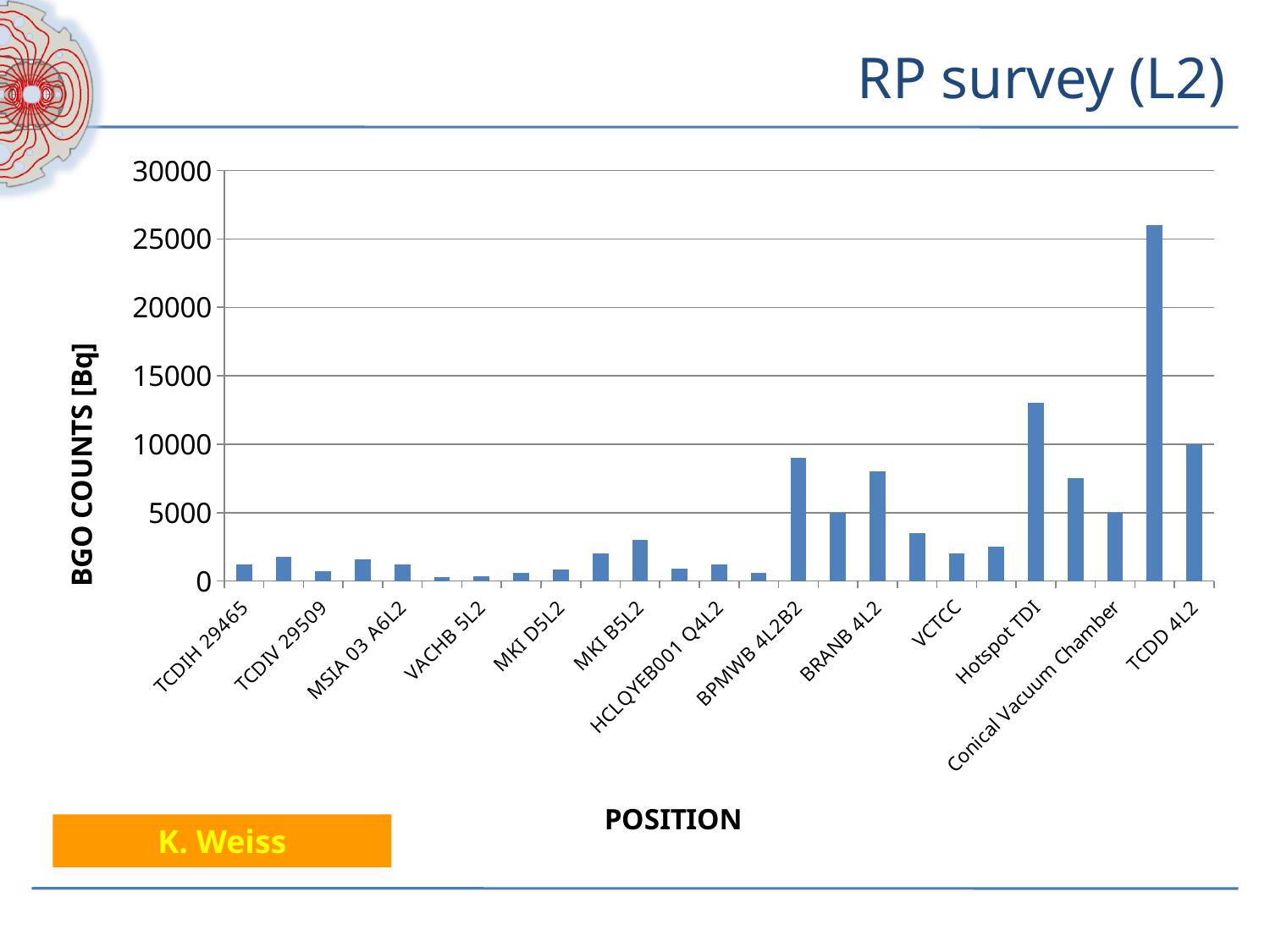
Is the value for MKI B5L2 greater or less than 5000? less What is the title of the chart on the slide? RP survey (L2) Which has the larger value, MKI B5L2 or VACHB 5L2? MKI B5L2 Is the value for Hotspot TDI greater or less than 10000? greater What kind of chart is shown on the slide? bar chart Which has the larger value, Hotspot TDI or BRANB 4L2? Hotspot TDI Is the value for BRANB 4L2 greater or less than 10000? less What is the label of the vertical axis? BGO COUNTS [Bq] Which has the larger value, BPMWB 4L2B2 or VCTCC? BPMWB 4L2B2